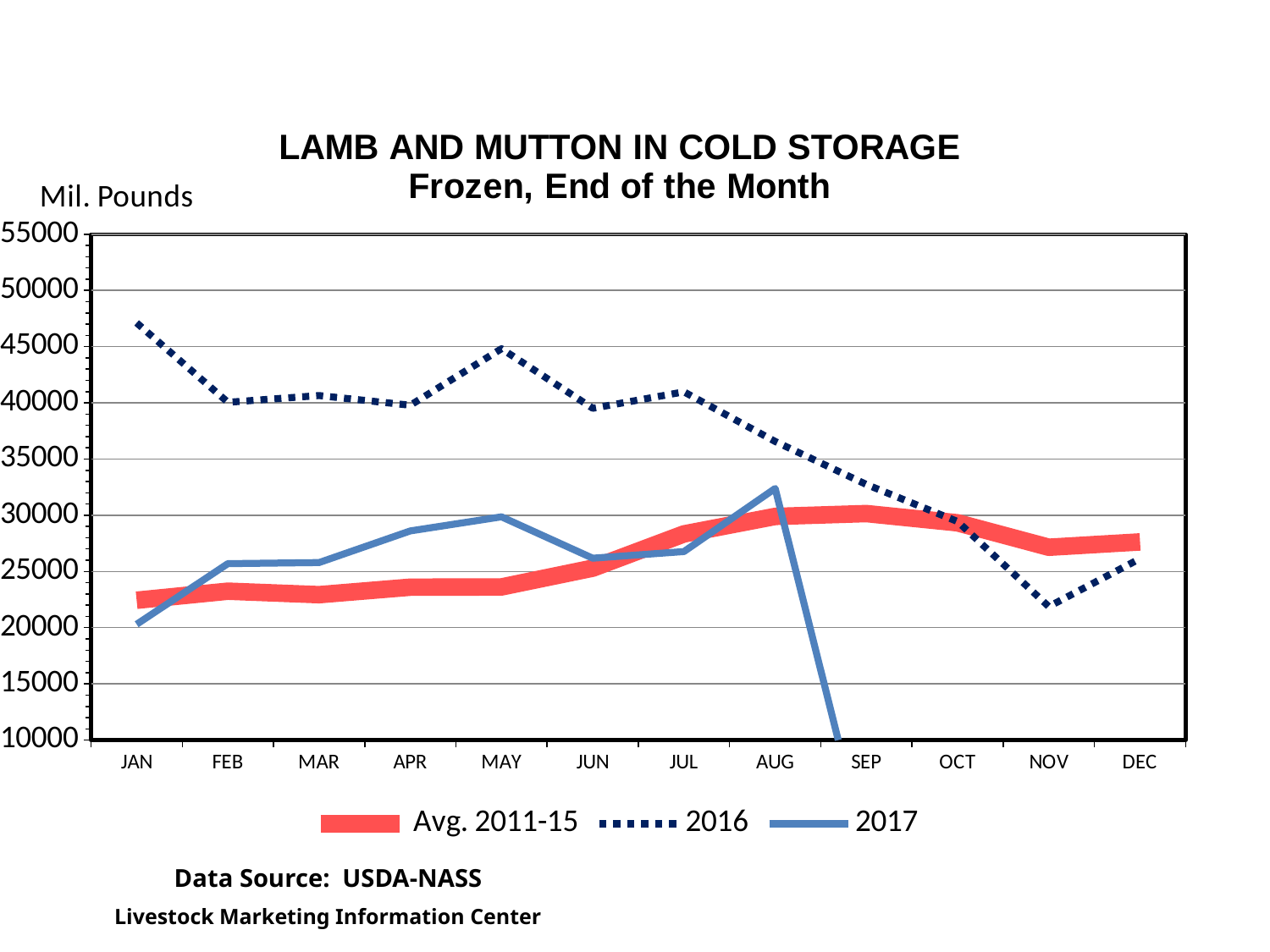
How many series does the legend list? 3 Does the 2016 series rise or fall from AUG to NOV? fall How many months are shown along the x axis? 12 Is the 2016 value for JAN greater or less than 45000? greater In which month does the 2016 series reach its lowest value? NOV Is the 2016 value for NOV greater or less than 25000? less Which series has the larger value in JAN, 2016 or 2017? 2016 Which series has the larger value in NOV, Avg. 2011-15 or 2016? Avg. 2011-15 In which month does the 2016 series reach its highest value? JAN Is the 2017 value for AUG greater or less than 30000? greater In which month does the 2017 series reach its highest value? AUG What kind of chart is shown on the slide? line chart